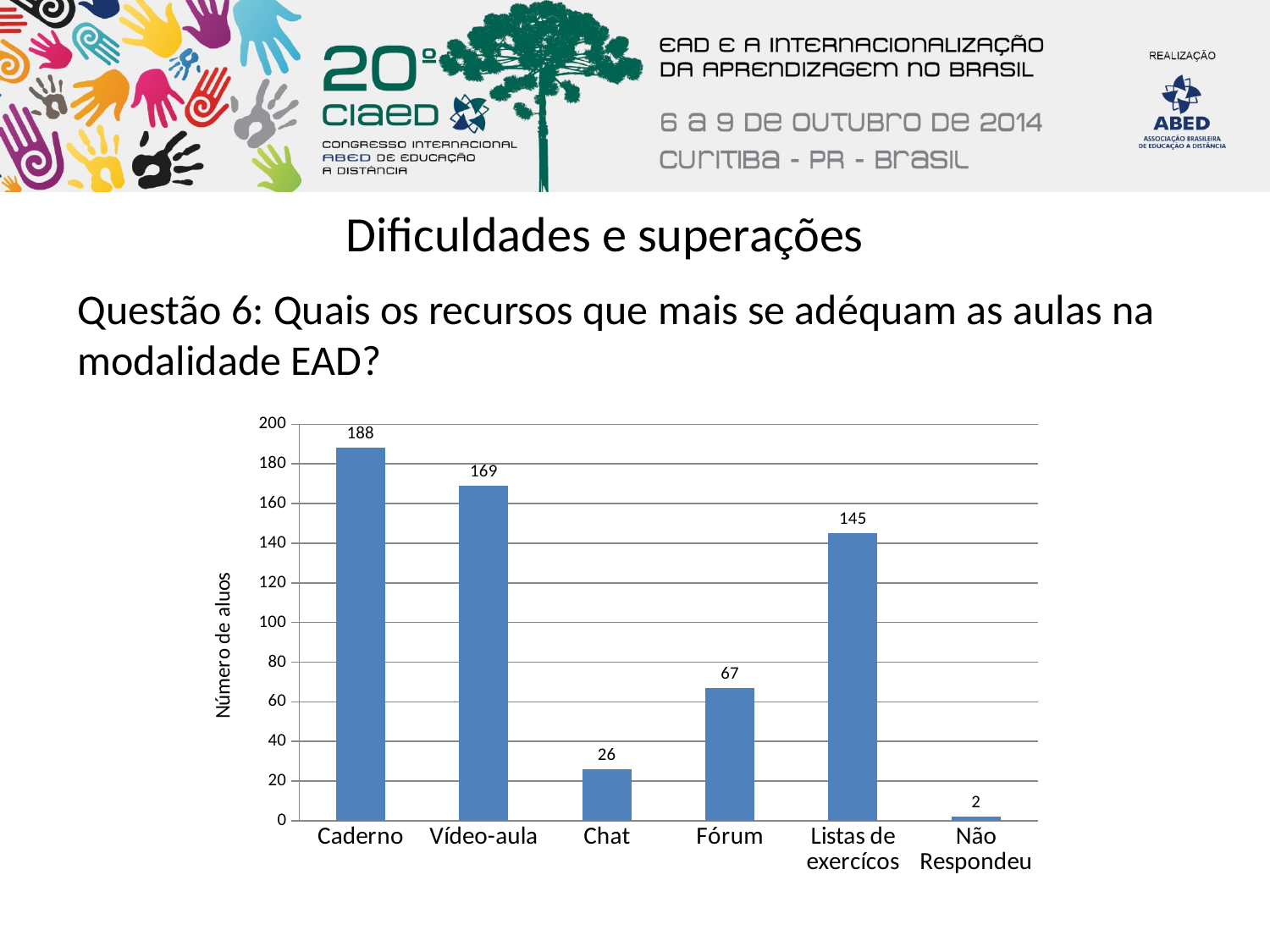
What is the value for Fórum? 67 What is the difference between the values for Listas de exercícos and Chat? 119 What is the value for Caderno? 188 What is the difference between the values for Caderno and Vídeo-aula? 19 What is the label of the vertical axis? Número de aluos Which is larger, the value for Fórum or the value for Chat? Fórum What kind of chart is shown on the slide? Bar chart How many categories are shown on the x axis? 6 What is the value for Não Respondeu? 2 Which category has the highest value? Caderno What is the value for Vídeo-aula? 169 Which category has the lowest value? Não Respondeu